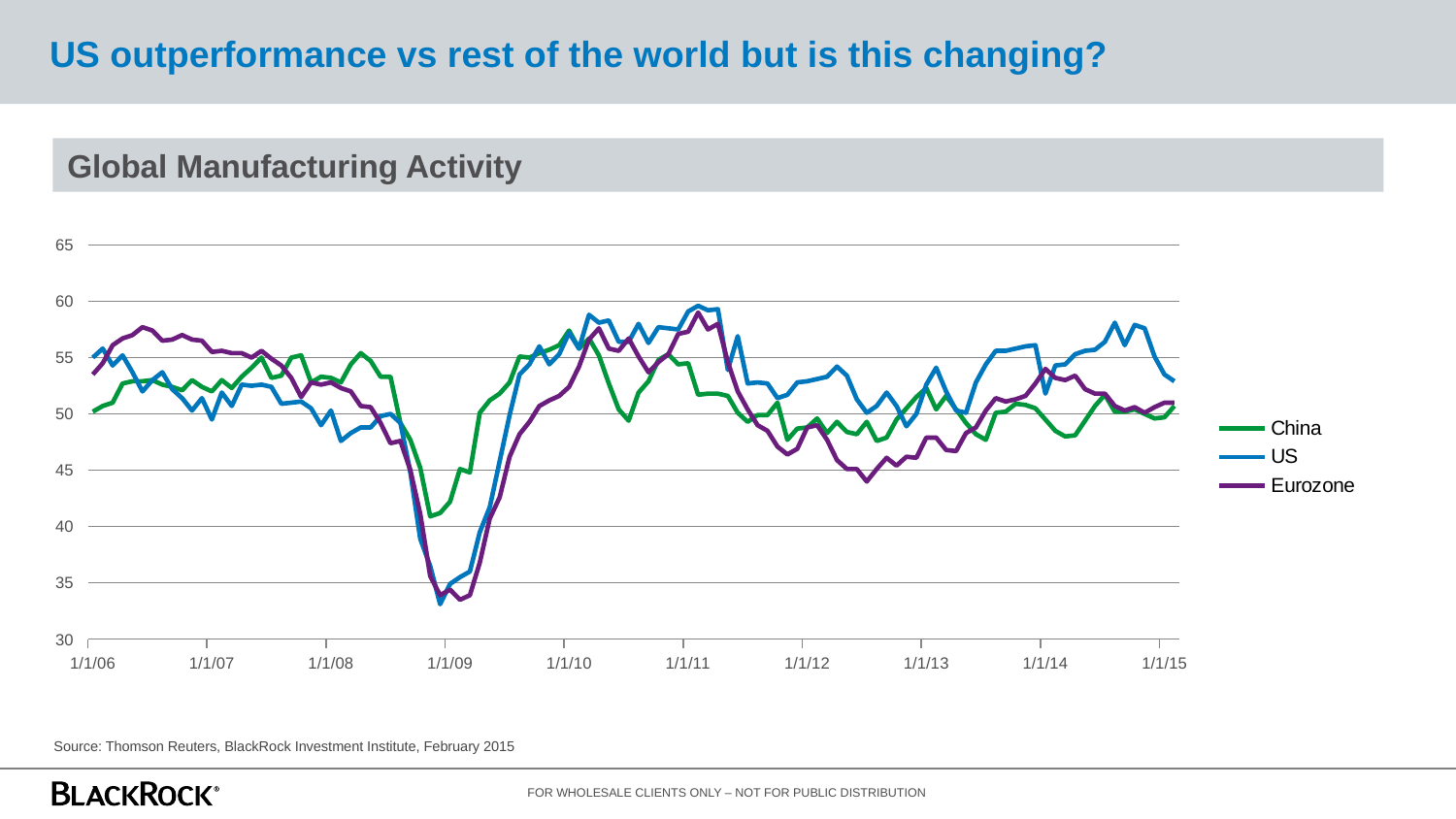
Which series is drawn in purple? Eurozone Is the value for the US at 1/1/11 greater or less than 55? greater How many year labels are shown on the x axis? 10 What is the title of the chart? Global Manufacturing Activity What kind of chart is shown on the slide? Line chart Is the value for the Eurozone in mid-2012 greater or less than 50? less At 1/1/14, which is higher, the US or China? US Is the value for China at 1/1/09 greater or less than 45? less At 1/1/09, which is higher, China or the US? China How many series does the legend list? 3 Does the US series rise or fall between 1/1/08 and 1/1/09? Fall